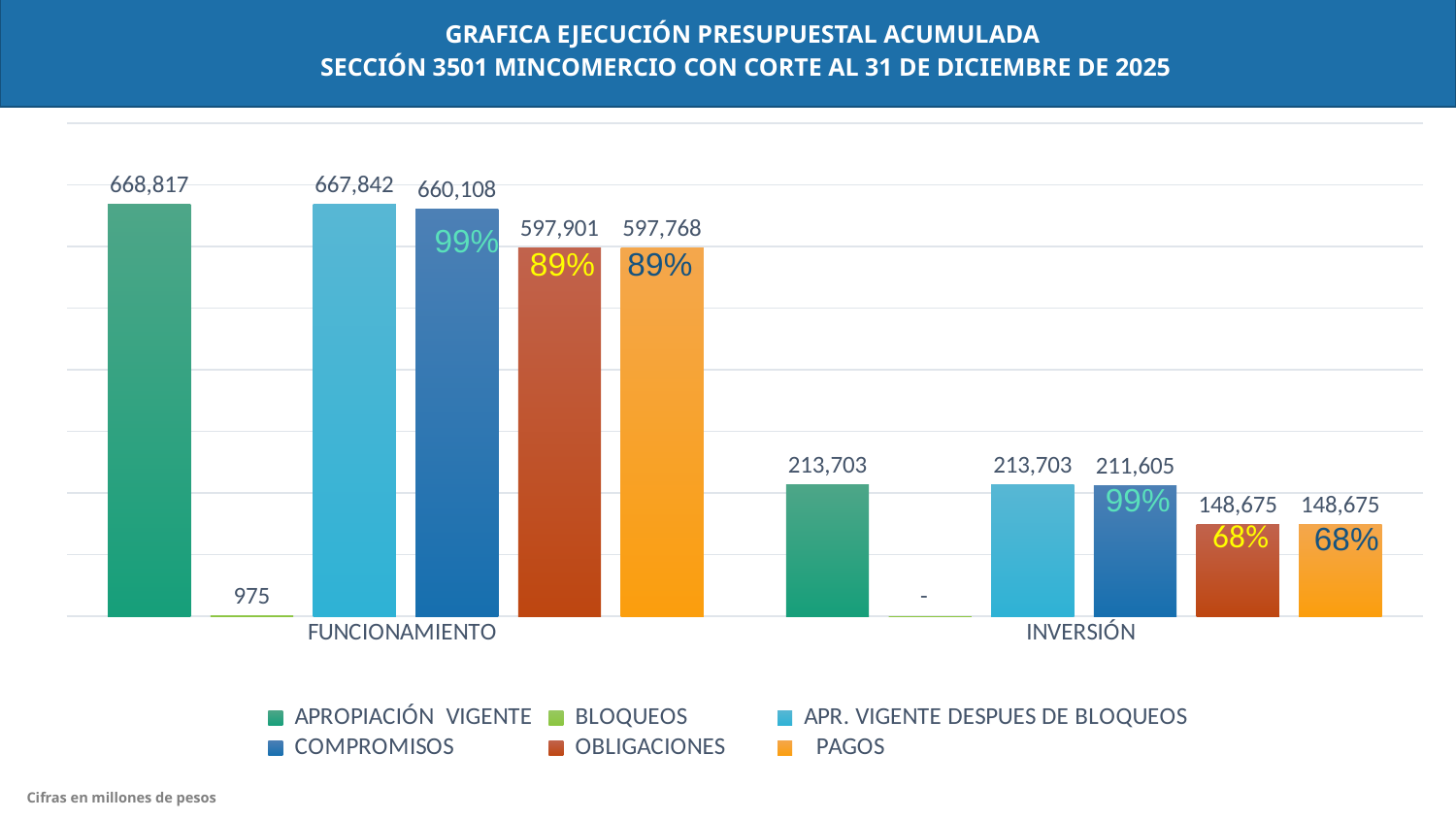
What is the value of PAGOS for INVERSIÓN? 148,675 What is the difference between OBLIGACIONES and PAGOS for FUNCIONAMIENTO? 133 How many categories are shown on the x axis? 2 Which category has the larger COMPROMISOS value, FUNCIONAMIENTO or INVERSIÓN? FUNCIONAMIENTO What is the difference between APROPIACIÓN VIGENTE and APR. VIGENTE DESPUES DE BLOQUEOS for FUNCIONAMIENTO? 975 What is the value of APROPIACIÓN VIGENTE for FUNCIONAMIENTO? 668,817 What is the value of COMPROMISOS for INVERSIÓN? 211,605 What is the difference between COMPROMISOS and OBLIGACIONES for INVERSIÓN? 62,930 What is the value of BLOQUEOS for FUNCIONAMIENTO? 975 How many series does the legend list? 6 Which series has the lowest value for FUNCIONAMIENTO? BLOQUEOS What kind of chart is shown on the slide? Bar chart